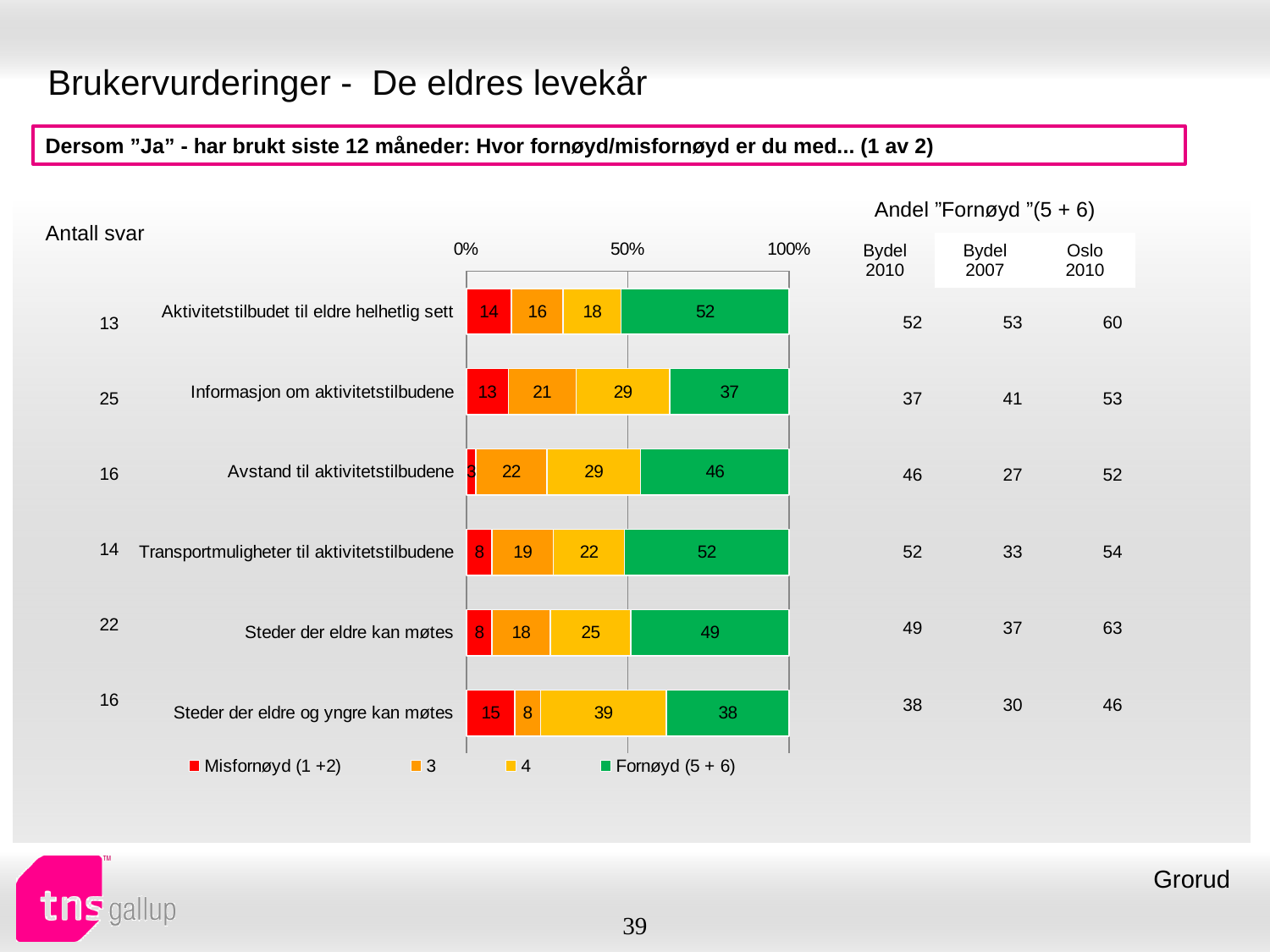
What is the value of "Fornøyd (5 + 6)" for "Aktivitetstilbudet til eldre helhetlig sett"? 52 Which category has the lowest value for series "4"? Aktivitetstilbudet til eldre helhetlig sett How many series does the chart legend list? 4 What is the value of "Misfornøyd (1 +2)" for "Steder der eldre og yngre kan møtes"? 15 What is the value of series "3" for "Informasjon om aktivitetstilbudene"? 21 What is the value of series "4" for "Steder der eldre kan møtes"? 25 What is the difference between the "Fornøyd (5 + 6)" values for "Aktivitetstilbudet til eldre helhetlig sett" and "Informasjon om aktivitetstilbudene"? 15 Which category has the highest value for series "4"? Steder der eldre og yngre kan møtes How many categories are plotted in the chart? 6 What is the first entry in the chart legend? Misfornøyd (1 +2) What kind of chart is shown on the slide? Stacked bar chart Which is larger: the series "4" value for "Informasjon om aktivitetstilbudene" or for "Aktivitetstilbudet til eldre helhetlig sett"? Informasjon om aktivitetstilbudene